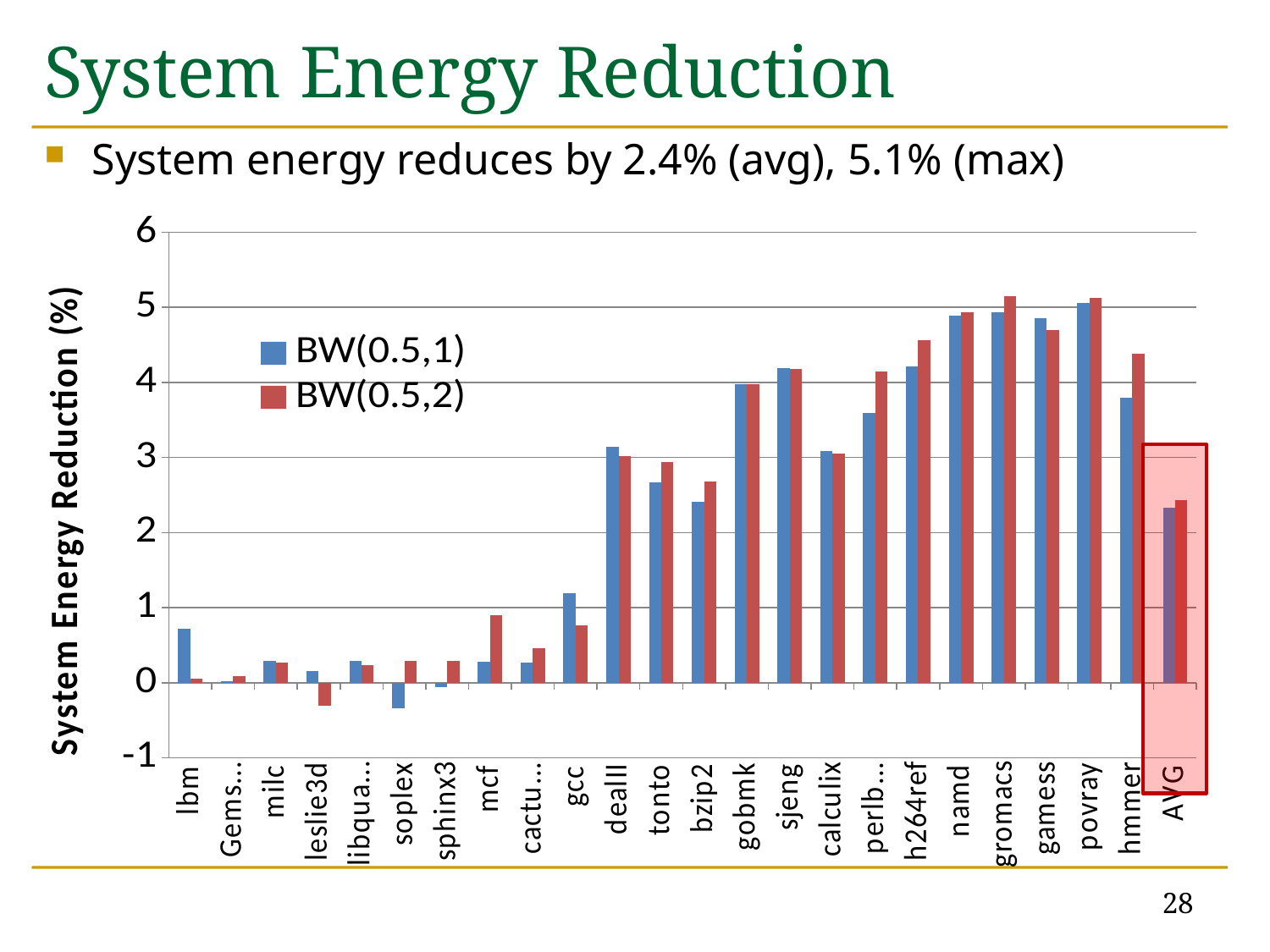
How many series does the legend list? 2 Which category has the lowest BW(0.5,2) value? leslie3d Do the BW(0.5,2) values generally rise or fall moving from lbm to hmmer along the x axis? rise How many categories are shown along the x axis, including AVG? 24 Is the BW(0.5,1) value for hmmer greater or less than 3? greater For gcc, which series has the larger value, BW(0.5,1) or BW(0.5,2)? BW(0.5,1) What are the two series named in the legend? BW(0.5,1) and BW(0.5,2) Which category has the lowest BW(0.5,1) value? soplex Is the BW(0.5,2) value for h264ref greater or less than 4? greater What kind of chart is shown on the slide? bar chart Is the BW(0.5,1) value for bzip2 greater or less than 3? less For hmmer, which series has the larger value, BW(0.5,1) or BW(0.5,2)? BW(0.5,2)